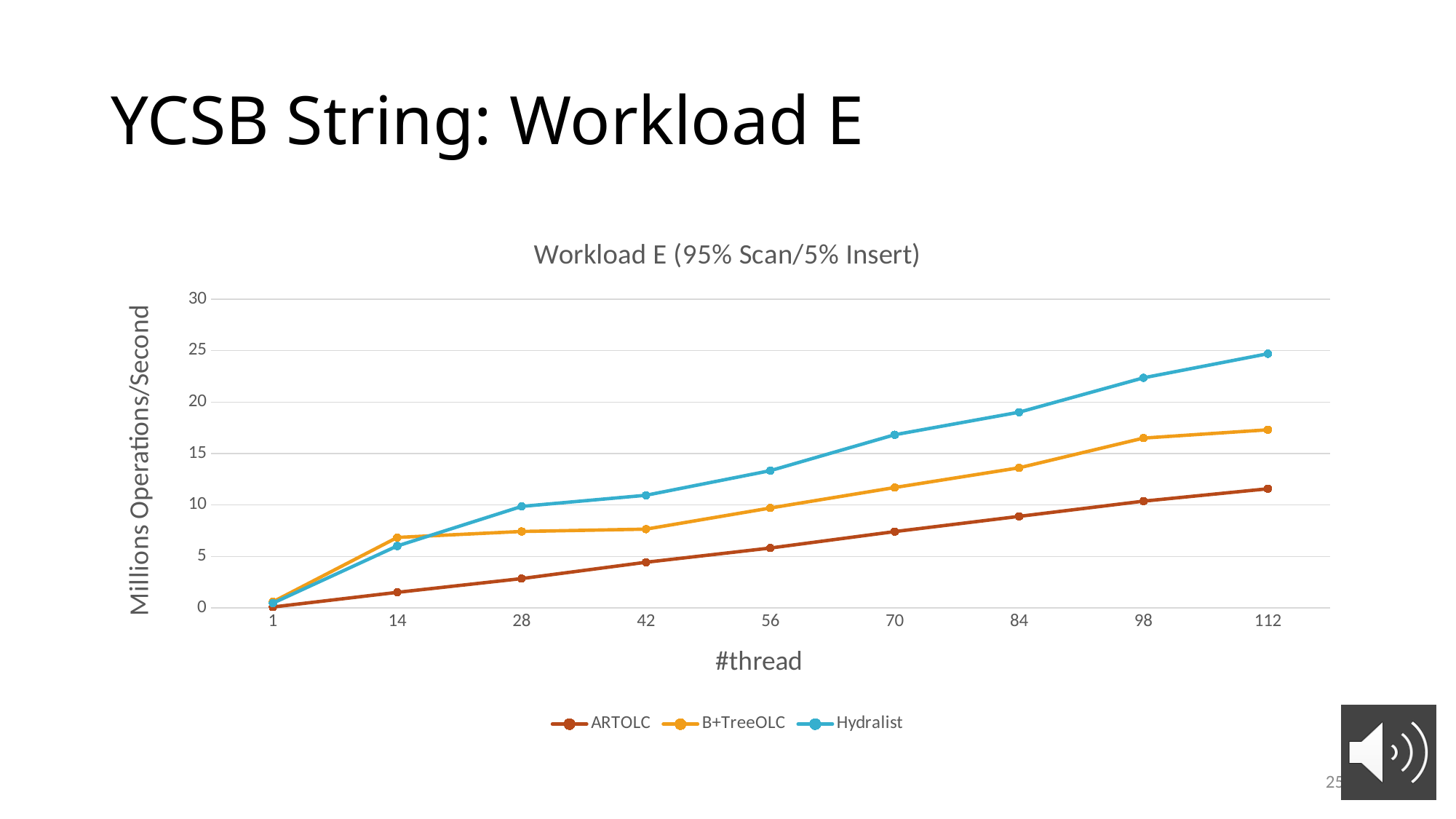
Does the ARTOLC series rise or fall as the number of threads increases? rises Is the value for ARTOLC at 28 threads greater or less than 5? less Is the value for ARTOLC at 112 threads greater or less than 15? less How many series does the legend list? 3 Which series has the lowest value at 112 threads? ARTOLC Is the value for B+TreeOLC at 56 threads greater or less than 5? greater What is the title of the chart? Workload E (95% Scan/5% Insert) How many thread counts are plotted along the x axis? 9 What kind of chart is shown on the slide? line chart At 28 threads, which is larger: Hydralist or B+TreeOLC? Hydralist Which series has the highest value at 112 threads? Hydralist